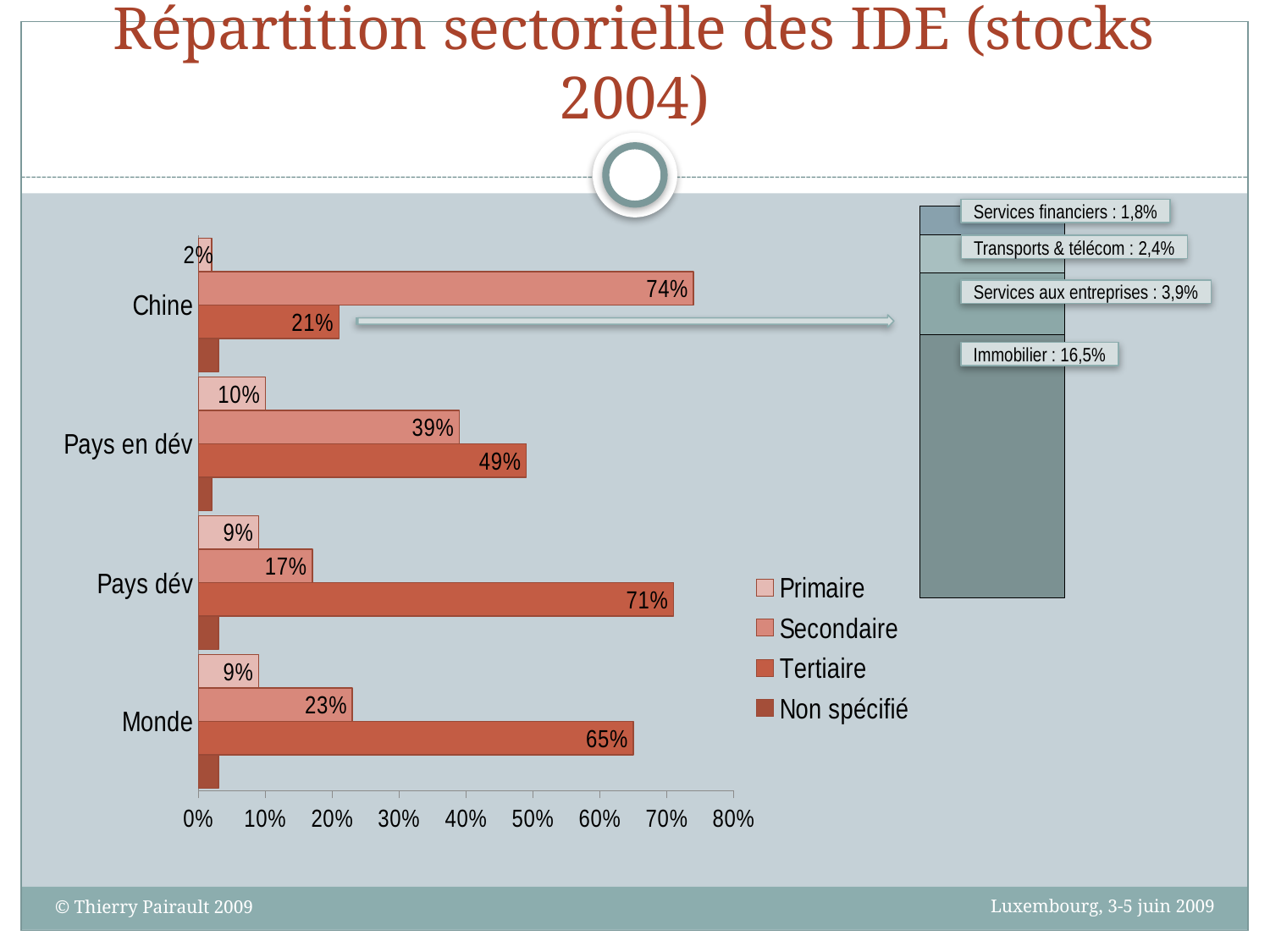
How many categories are shown on the y axis of the bar chart? 4 What is the Primaire value for Pays dév? 9% What type of chart is shown on the slide? bar chart Is the Non spécifié value for Chine greater or less than 10%? less Which is larger for Pays en dév: the Secondaire value or the Tertiaire value? Tertiaire Which category has the highest Tertiaire value? Pays dév How many series does the legend list? 4 What is the Secondaire value for Chine? 74% What is the Tertiaire value for Pays en dév? 49% What is the Secondaire value for Monde? 23% Which category has the lowest Primaire value? Chine What is the difference between the Tertiaire value for Pays dév and the Tertiaire value for Monde? 6%